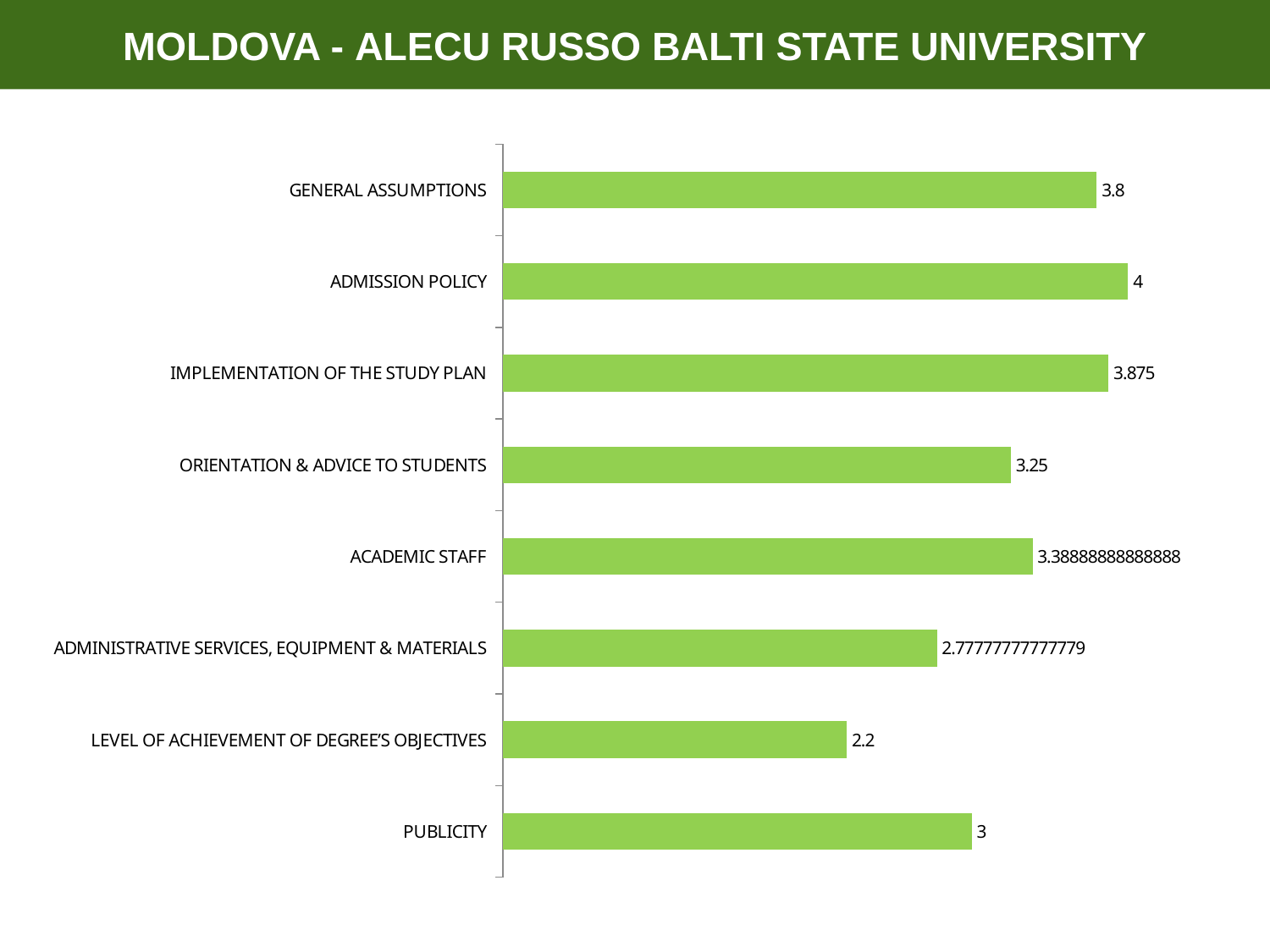
What is the value for IMPLEMENTATION OF THE STUDY PLAN? 3.875 What is the value for PUBLICITY? 3 What is the difference between the values for PUBLICITY and LEVEL OF ACHIEVEMENT OF DEGREE'S OBJECTIVES? 0.8 Which category has the highest value? ADMISSION POLICY Which is larger, the value for ORIENTATION & ADVICE TO STUDENTS or the value for ACADEMIC STAFF? ACADEMIC STAFF How many categories are shown in the chart? 8 What is the value for LEVEL OF ACHIEVEMENT OF DEGREE'S OBJECTIVES? 2.2 What kind of chart is shown on the slide? Bar chart What is the value for ADMISSION POLICY? 4 Which category has the lowest value? LEVEL OF ACHIEVEMENT OF DEGREE'S OBJECTIVES What is the value for ACADEMIC STAFF? 3.38888888888888 What is the difference between the values for ADMISSION POLICY and GENERAL ASSUMPTIONS? 0.2